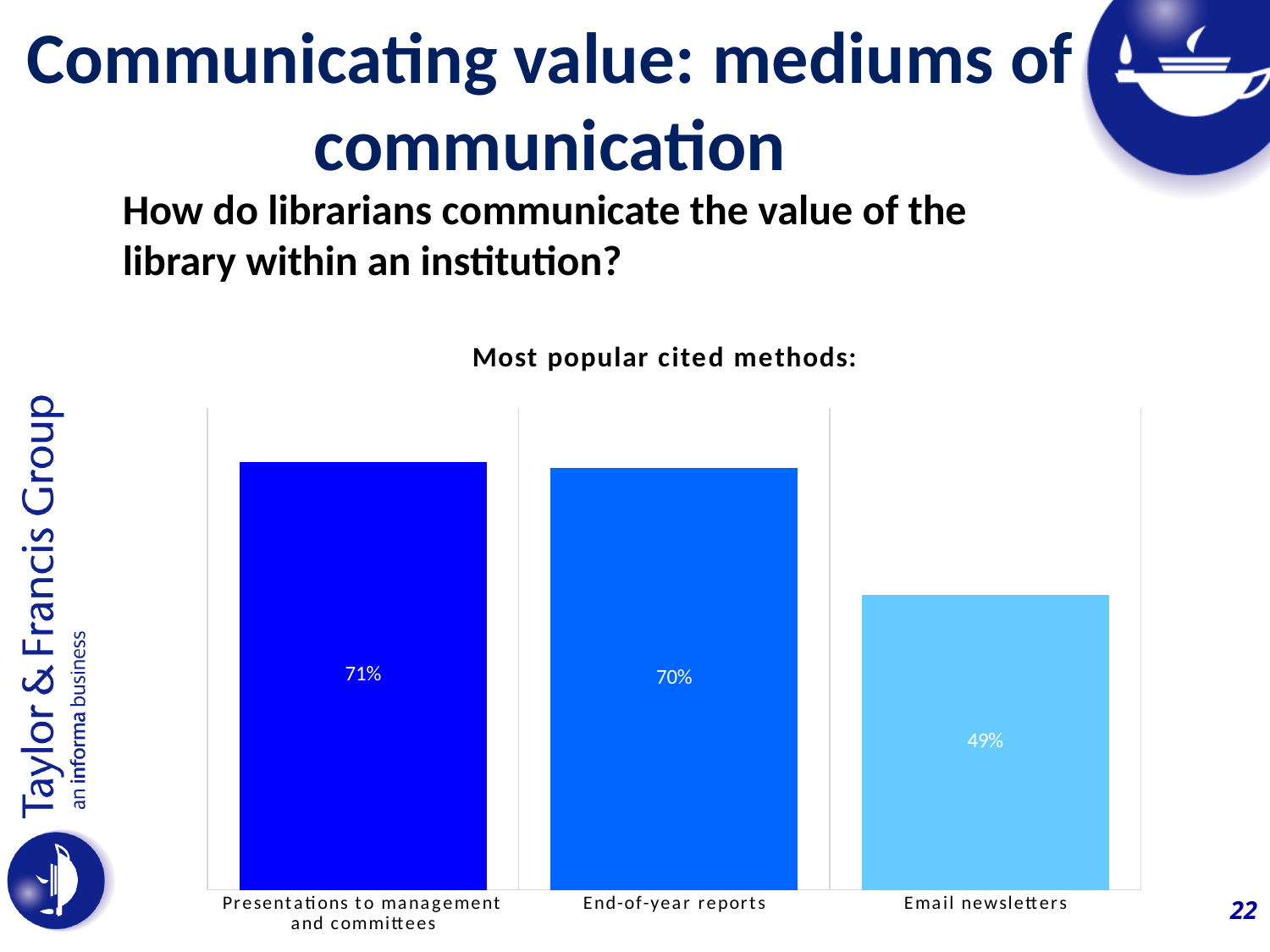
What kind of chart is shown on the slide? Bar chart What is the title of the chart? Most popular cited methods: What is the difference between the values for Presentations to management and committees and Email newsletters? 22% What is the value for Presentations to management and committees? 71% Do the values rise or fall from left to right across the chart? Fall Which is larger, the value for End-of-year reports or the value for Email newsletters? End-of-year reports How many methods are shown in the chart? 3 What is the difference between the values for End-of-year reports and Email newsletters? 21% What is the value for End-of-year reports? 70% What is the value for Email newsletters? 49% Which method has the lowest value? Email newsletters What is the difference between the values for Presentations to management and committees and End-of-year reports? 1%